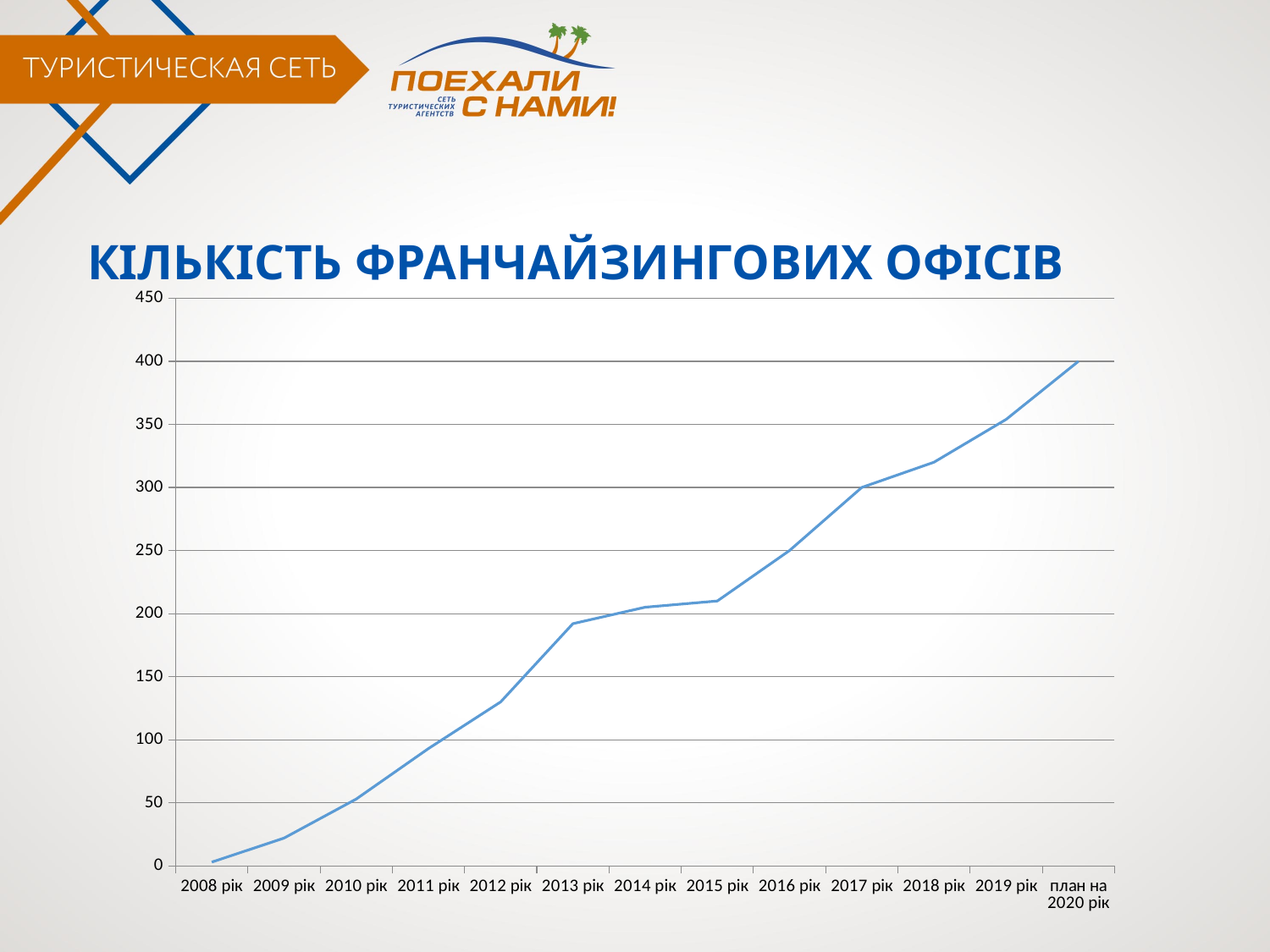
What is the value for 2017 рік? 300 Which category has the highest value? план на 2020 рік What is the title of the chart? КІЛЬКІСТЬ ФРАНЧАЙЗИНГОВИХ ОФІСІВ Is the value for 2012 рік greater or less than 150? less Which is larger, the value for 2013 рік or the value for 2012 рік? 2013 рік Is the value for 2018 рік greater or less than 300? greater What is the value for план на 2020 рік? 400 Which category has the lowest value? 2008 рік Do the values rise or fall from 2008 рік to план на 2020 рік? rise What kind of chart is shown on the slide? line chart How many years (categories) are plotted along the x axis? 13 Is the value for 2013 рік greater or less than 150? greater